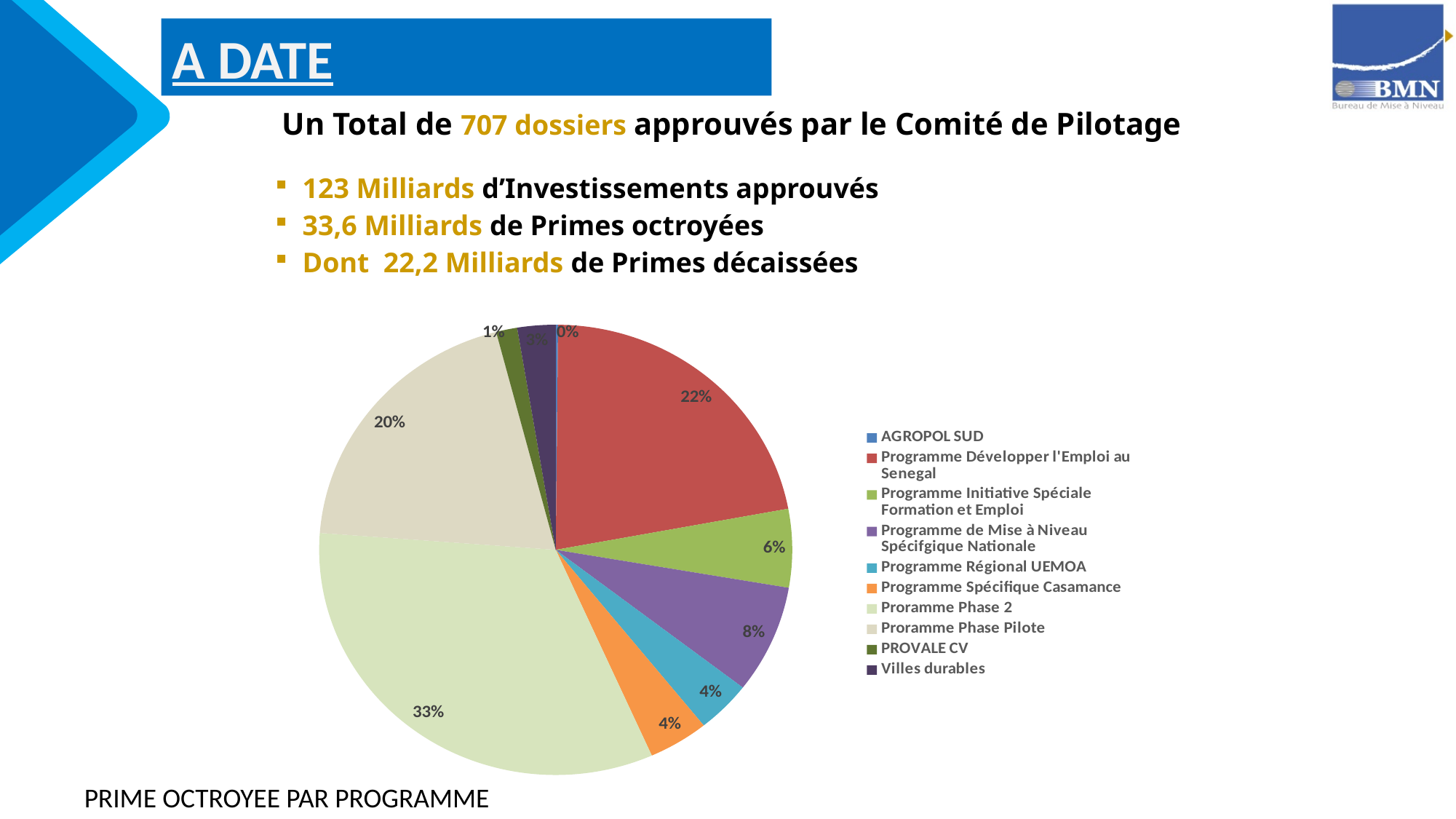
How many programmes are listed in the chart legend? 10 What is the difference in percentage points between Proramme Phase 2 and Proramme Phase Pilote? 13 What percentage is shown for Villes durables? 3% Which programme has the largest slice of the pie? Proramme Phase 2 What share of the pie does Proramme Phase 2 represent? 33% Which programme has the smallest slice of the pie? AGROPOL SUD What is the title written below the chart? PRIME OCTROYEE PAR PROGRAMME What type of chart is shown on the slide? Pie chart What percentage is shown for Programme Développer l'Emploi au Senegal? 22% What percentage is shown for Programme de Mise à Niveau Spécifgique Nationale? 8% Which is larger: the slice for Programme Initiative Spéciale Formation et Emploi or the slice for Programme de Mise à Niveau Spécifgique Nationale? Programme de Mise à Niveau Spécifgique Nationale What percentage is shown for Proramme Phase Pilote? 20%